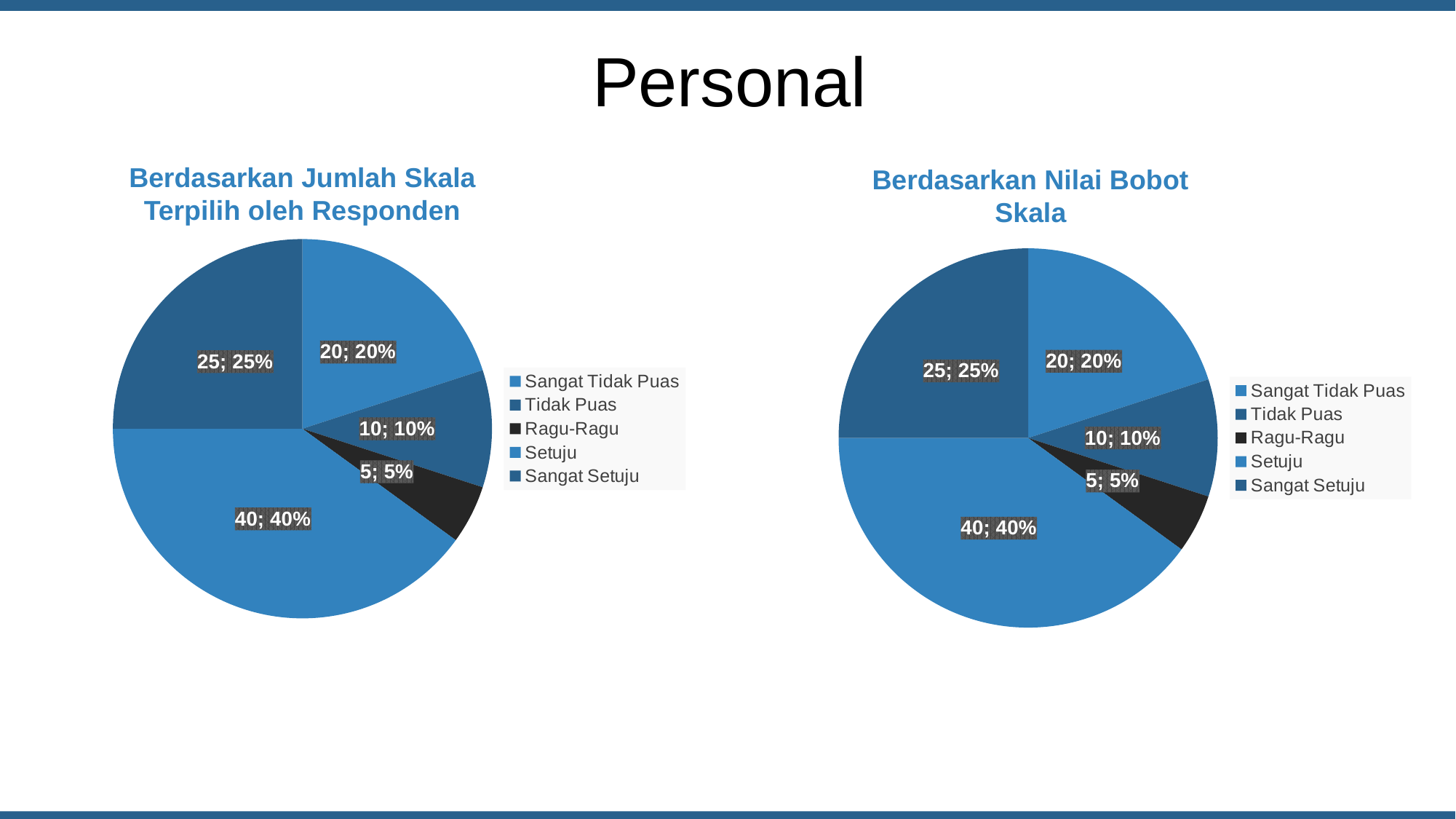
In the left chart, what value is shown for the Sangat Setuju slice? 25; 25% What share of the pie does Sangat Tidak Puas take in the chart titled "Berdasarkan Nilai Bobot Skala"? 20% What type of chart is the chart titled "Berdasarkan Nilai Bobot Skala"? Pie chart In the chart titled "Berdasarkan Nilai Bobot Skala", which category has the smallest slice? Ragu-Ragu In the chart titled "Berdasarkan Jumlah Skala Terpilih oleh Responden", what value is shown for the Setuju slice? 40; 40% How many slices does the left pie chart have? 5 In the right chart, what value is shown for the Tidak Puas slice? 10; 10% In the left chart, what is the difference between the Setuju value and the Sangat Setuju value? 15 In the chart titled "Berdasarkan Jumlah Skala Terpilih oleh Responden", which category has the largest slice? Setuju How many entries does the legend of the left chart list? 5 In the chart titled "Berdasarkan Nilai Bobot Skala", what value is shown for the Ragu-Ragu slice? 5; 5% In the right chart, which is larger, Sangat Tidak Puas or Tidak Puas? Sangat Tidak Puas